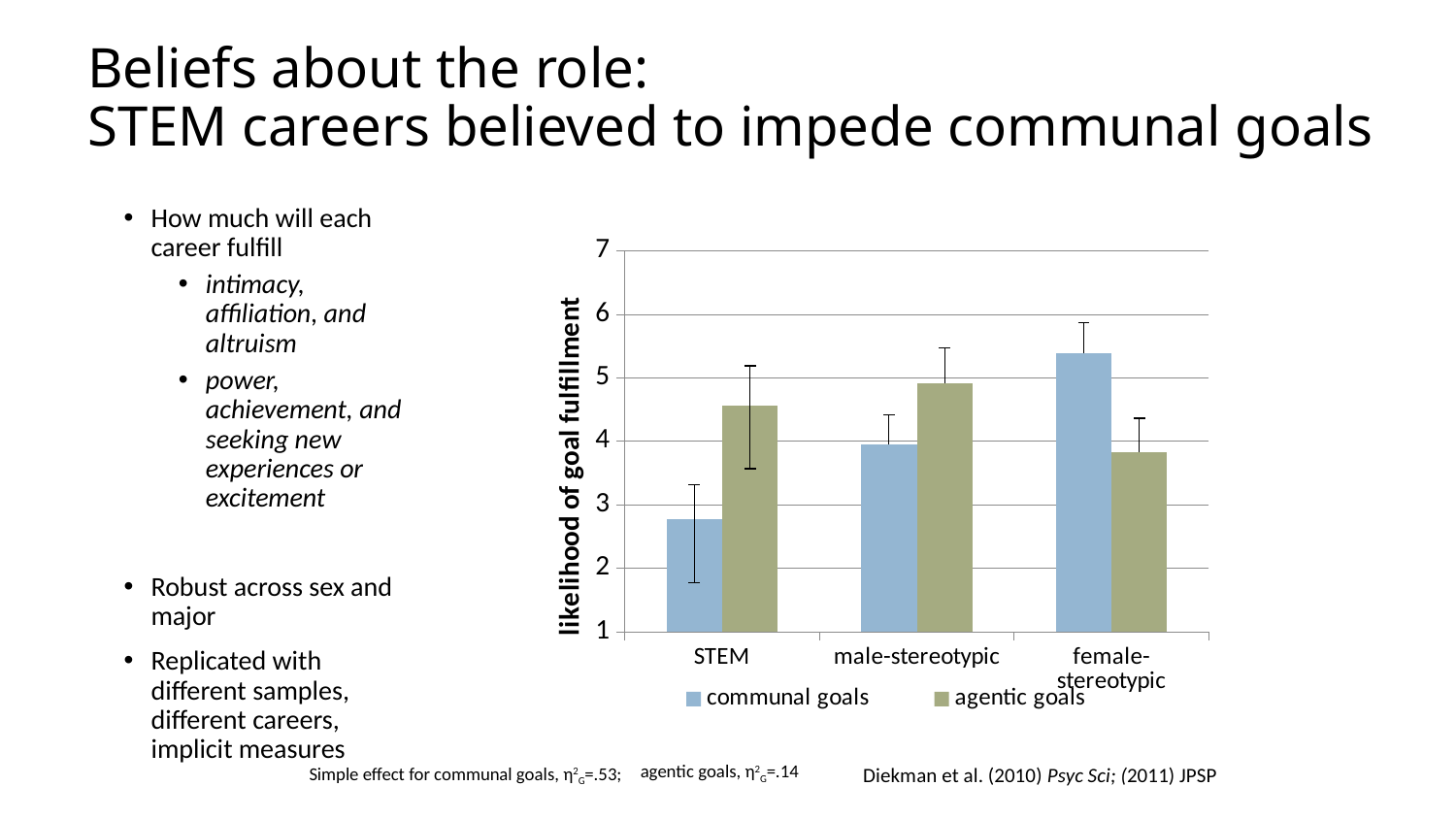
Which career category has the lowest value for agentic goals? female-stereotypic For female-stereotypic careers, which is larger: communal goals or agentic goals? communal goals Is the value for communal goals in STEM greater or less than 3? less How many career categories are shown on the x axis? 3 How many series does the chart's legend list? 2 Which career category has the highest value for communal goals? female-stereotypic What kind of chart is shown on the slide? bar chart What is the title of the vertical axis? likelihood of goal fulfillment Do the communal goals values rise or fall moving from STEM to male-stereotypic to female-stereotypic? rise Which career category has the lowest value for communal goals? STEM Is the value for communal goals in female-stereotypic careers greater or less than 5? greater For STEM, which is larger: communal goals or agentic goals? agentic goals